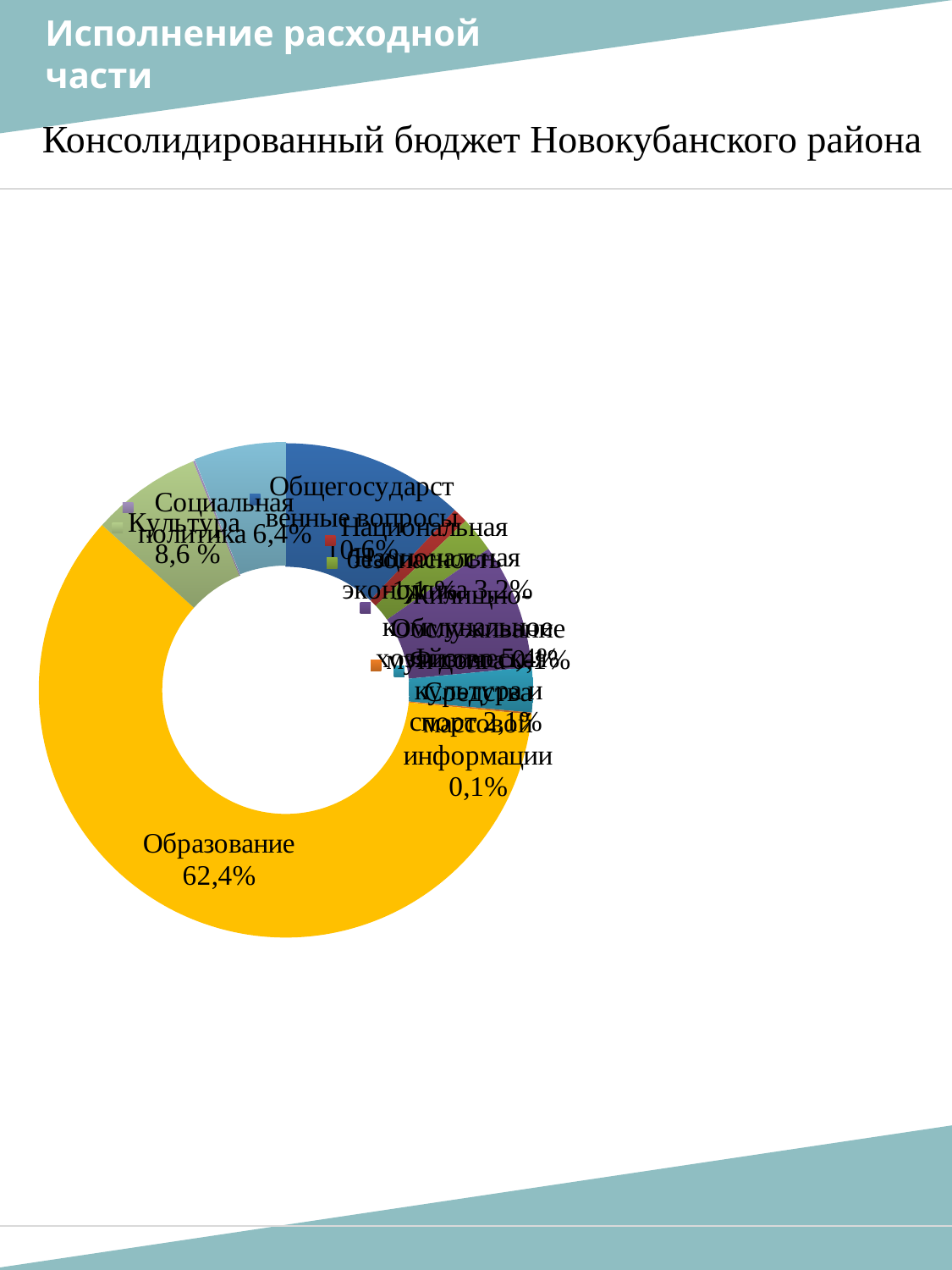
By how many percentage points does Образование exceed Общегосударственные вопросы? 51,8 Which is larger, the share for Культура or for Социальная политика? Культура What is the difference between the shares of Культура and Социальная политика? 2,2 Which category has the largest share of the chart? Образование What is the value shown for Культура? 8,6 % What share of the chart does Образование account for? 62,4% Which category is shown in yellow on the chart? Образование What kind of chart is shown on the slide? Doughnut (pie) chart What is the value shown for Общегосударственные вопросы? 10,6% What is the title written above the chart? Консолидированный бюджет Новокубанского района Is the share for Образование greater or less than 50%? greater What is the value shown for Социальная политика? 6,4%